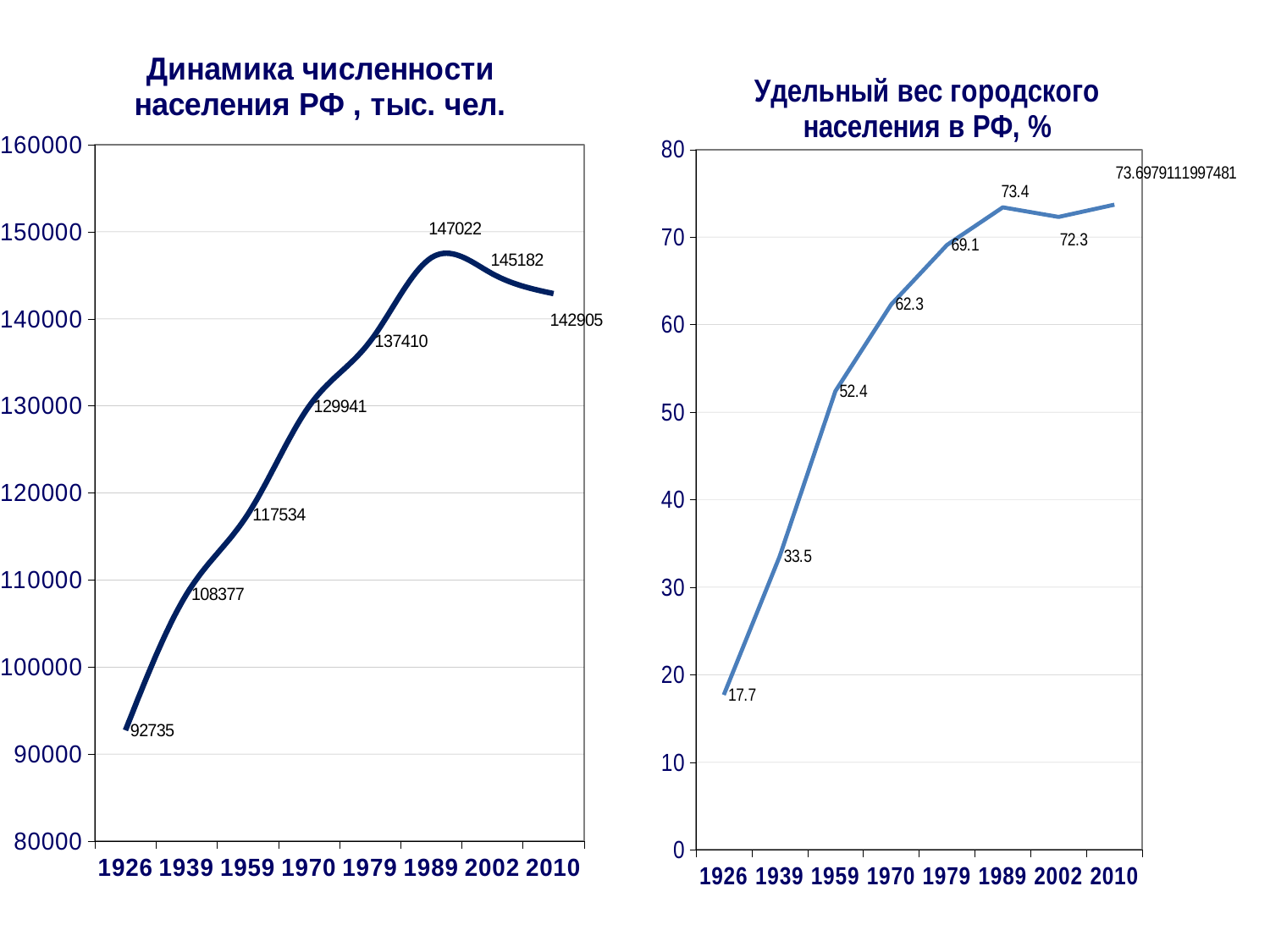
In the chart titled "Динамика численности населения РФ, тыс. чел.", which year has the lowest value? 1926 In the chart titled "Динамика численности населения РФ, тыс. чел.", how many data points are plotted? 8 In the chart titled "Удельный вес городского населения в РФ, %", what is the value for 1989? 73.4 In the chart titled "Удельный вес городского населения в РФ, %", what is the value for 1959? 52.4 In the chart titled "Удельный вес городского населения в РФ, %", what is the difference between the values for 1939 and 1926? 15.8 In the chart titled "Удельный вес городского населения в РФ, %", which is larger, the value for 1989 or the value for 2002? 1989 In the chart titled "Динамика численности населения РФ, тыс. чел.", what is the difference between the values for 2002 and 2010? 2277 In the chart titled "Динамика численности населения РФ, тыс. чел.", what is the value for 1989? 147022 In the chart titled "Динамика численности населения РФ, тыс. чел.", which year has the highest value? 1989 What type of chart is the chart titled "Удельный вес городского населения в РФ, %"? line chart In the chart titled "Динамика численности населения РФ, тыс. чел.", what is the value for 1926? 92735 In the chart titled "Удельный вес городского населения в РФ, %", do the values generally rise or fall from 1926 to 1989? rise